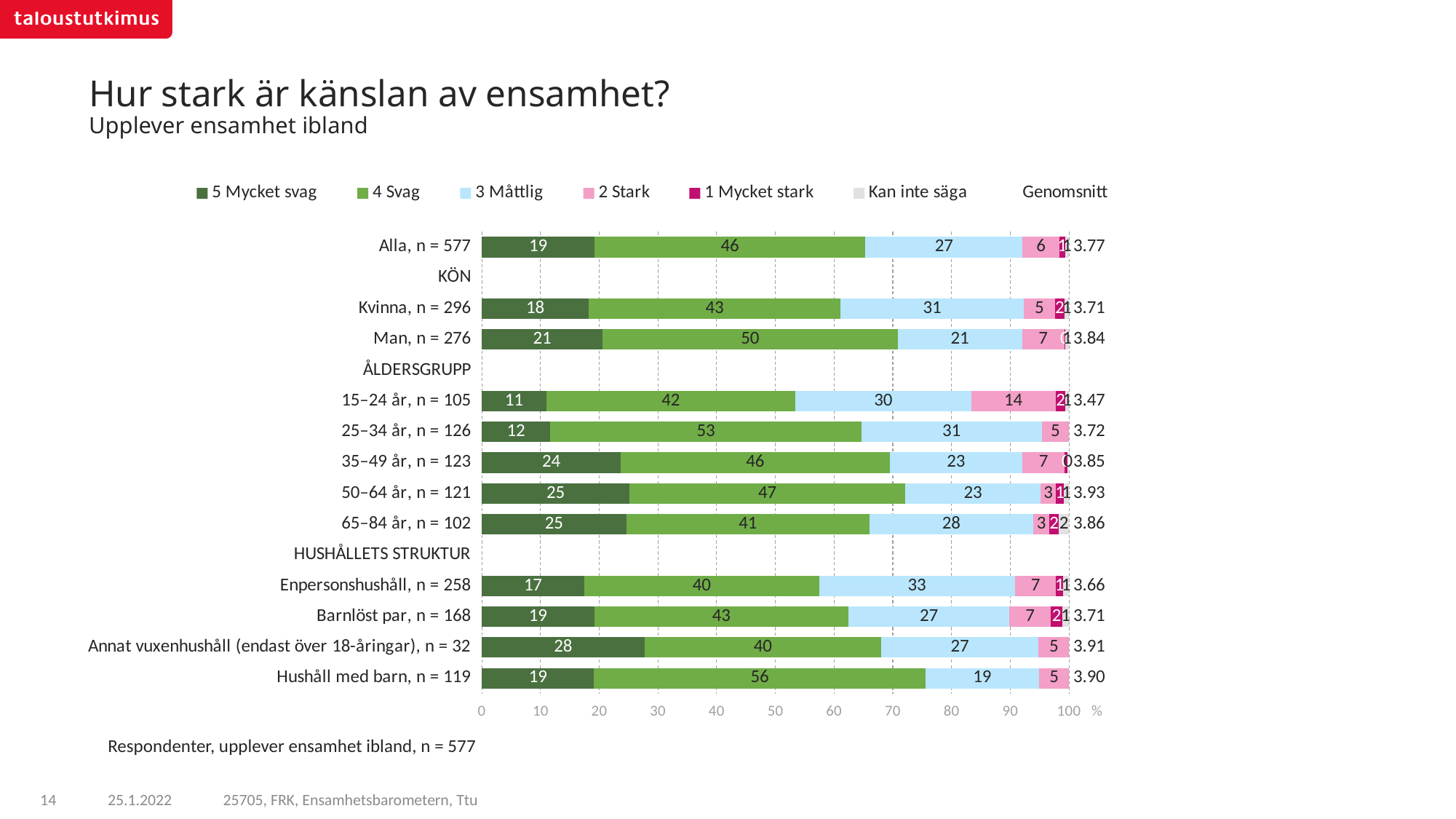
What percentage of the '15–24 år, n = 105' group answered '2 Stark'? 14 Which group has the highest '4 Svag' percentage? Hushåll med barn, n = 119 Which has a higher '5 Mycket svag' percentage: '35–49 år, n = 123' or '25–34 år, n = 126'? 35–49 år, n = 123 What kind of chart is shown on the slide? Stacked horizontal bar chart What is the difference in the '3 Måttlig' percentage between 'Kvinna, n = 296' and 'Man, n = 276'? 10 How many groups (bars) are plotted in the chart? 12 How many response categories (coloured series) does the legend list, excluding Genomsnitt? 6 What percentage of the 'Alla, n = 577' group answered '4 Svag'? 46 What is the Genomsnitt (average) value shown for 'Man, n = 276'? 3.84 Which group has the lowest Genomsnitt (average) value? 15–24 år, n = 105 What is the Genomsnitt (average) value for 'Enpersonshushåll, n = 258'? 3.66 Which group has the highest '5 Mycket svag' percentage? Annat vuxenhushåll (endast över 18-åringar), n = 32